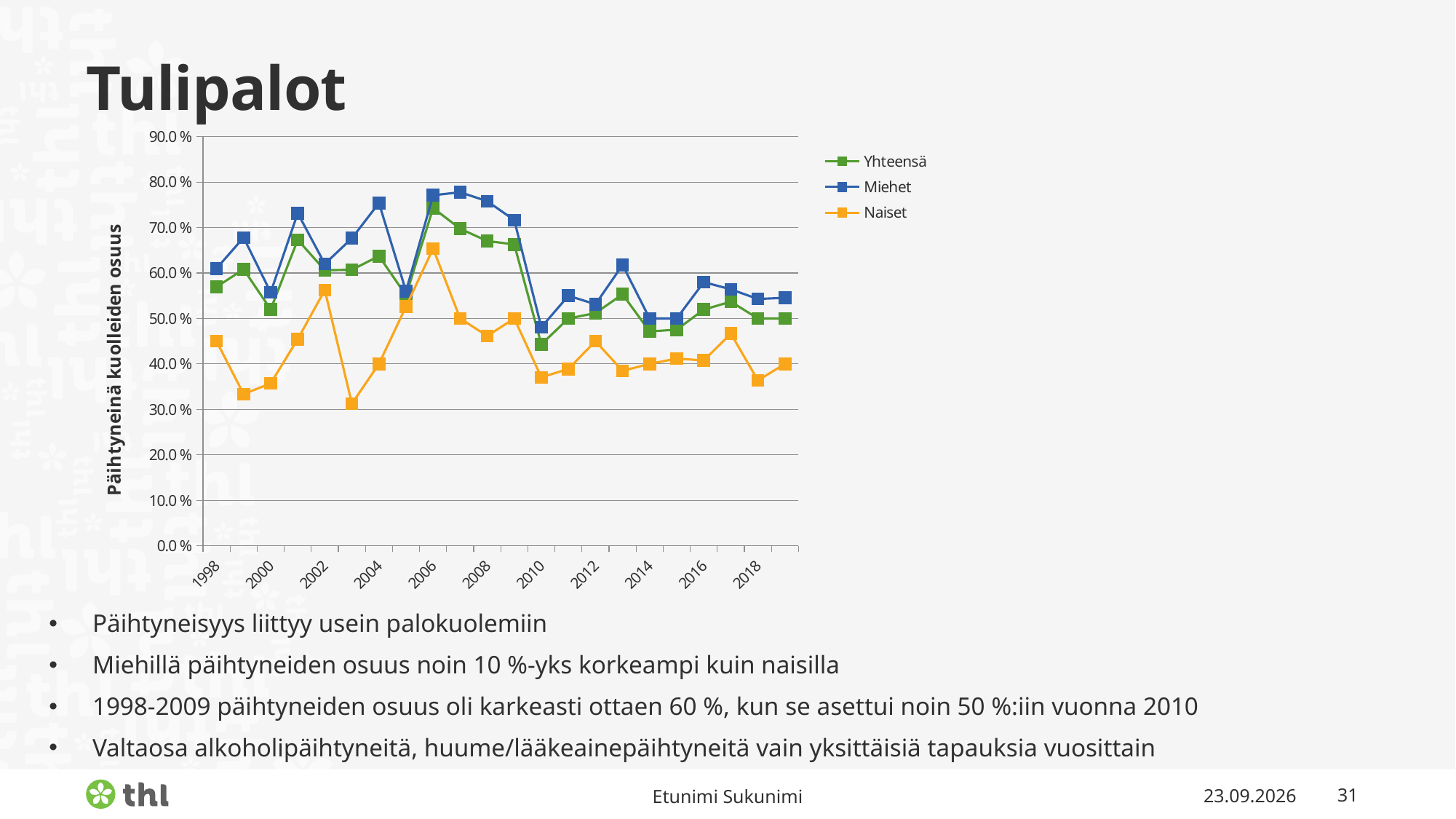
Is the value for Miehet in 2007 greater or less than 70.0 %? greater Is the value for Naiset in 2003 greater or less than 40.0 %? less Which series has the highest value in 2006? Miehet What is the title of the vertical axis of the chart? Päihtyneinä kuolleiden osuus What are the series names listed in the chart legend? Yhteensä, Miehet, Naiset What kind of chart is shown on the slide? line chart Does the value for Naiset rise or fall from 2002 to 2003? fall Which is larger in 2010, the value for Miehet or the value for Naiset? Miehet Which series has the lowest value in 2003? Naiset Is the value for Naiset in 1999 greater or less than 40.0 %? less How many series does the chart legend list? 3